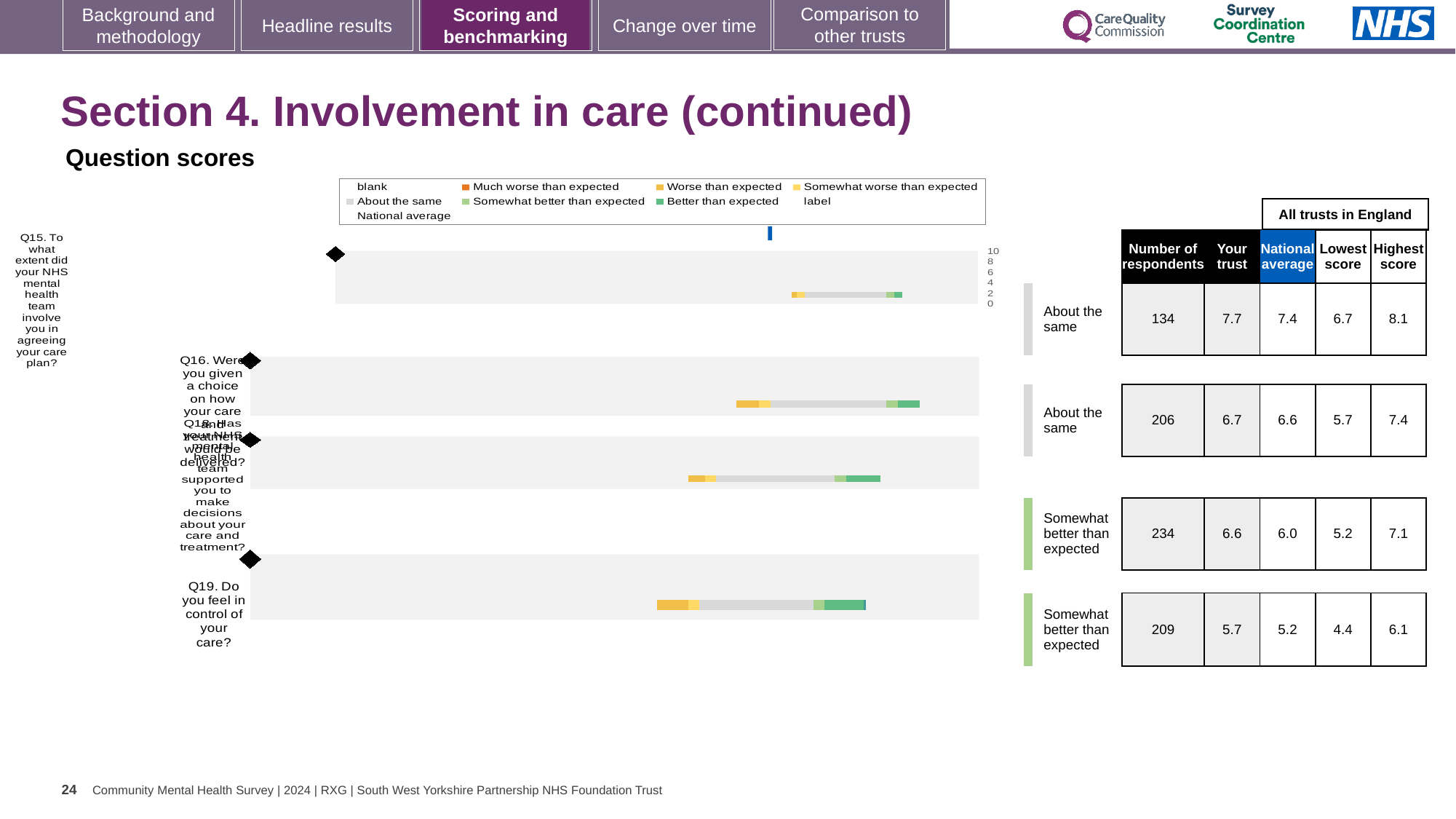
What is the national average score for Q19 (Do you feel in control of your care?)? 5.2 What kind of chart is used to show the question scores on this slide? bar chart Which question has the highest 'Your trust' score? Q15 What benchmark category is shown for Q18? Somewhat better than expected What is the difference between the 'Your trust' score and the national average for Q18? 0.6 What is the highest score among all trusts in England for Q16? 7.4 For Q16, which is larger: the 'Your trust' score or the national average? Your trust Which question has the fewest respondents? Q15 What is the difference between the highest and lowest scores in England for Q19? 1.7 What is the 'Your trust' score for Q15 (involvement in agreeing your care plan)? 7.7 How many survey questions are plotted in the question scores chart? 4 How many respondents answered Q18? 234